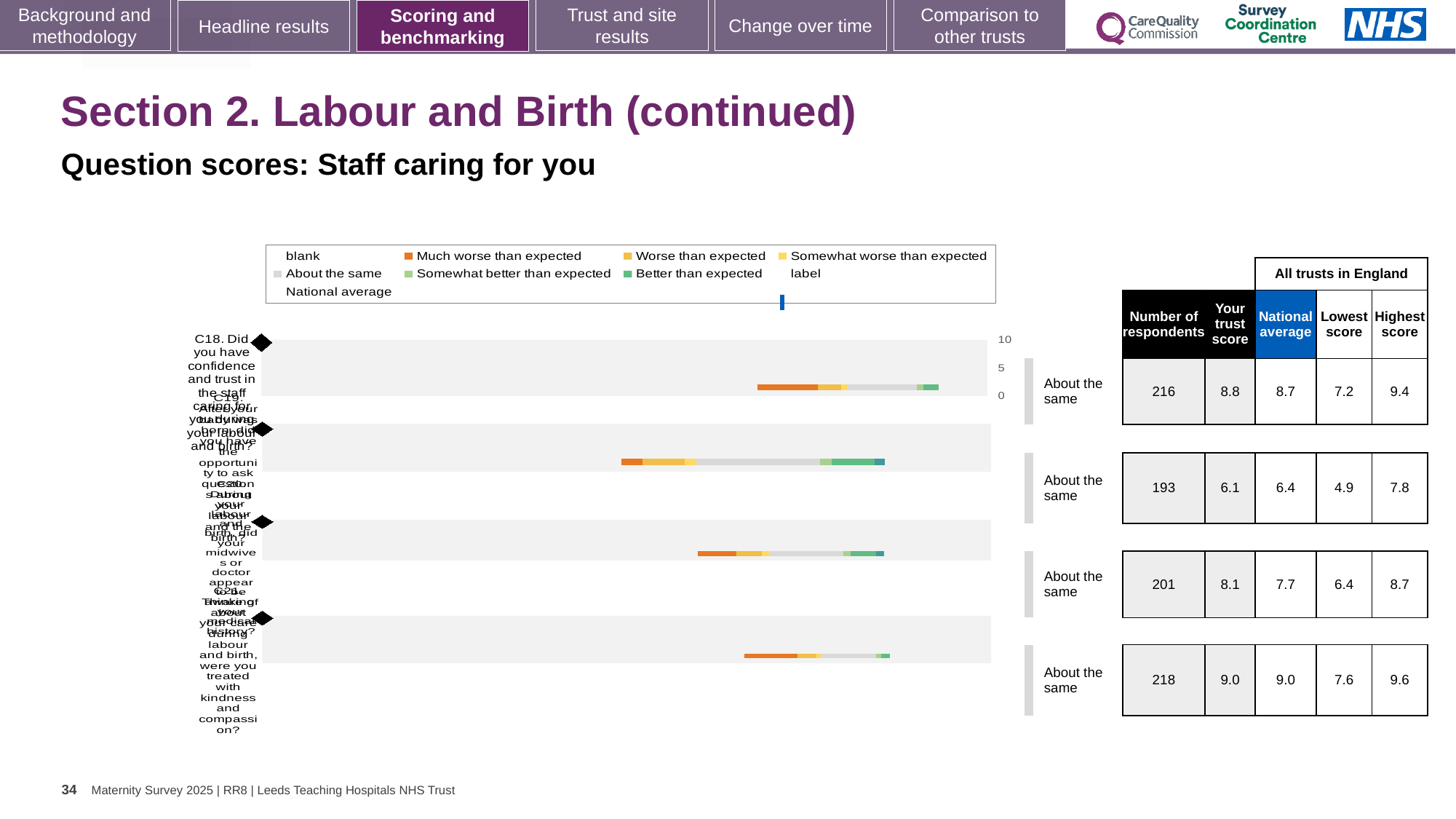
For C18, which is larger: the trust score or the national average? Your trust score What colour represents 'Much worse than expected' in the legend? orange For C18, what is the difference between the highest score (9.4) and the lowest score (7.2)? 2.2 How many question rows (bars) does the chart show? 4 How many respondents are listed for C18 (the first row)? 216 What is the 'Your trust score' for C18 (confidence and trust in the staff caring for you)? 8.8 What is the national average for C18 (confidence and trust in the staff caring for you)? 8.7 What is the highest score across all trusts in England for the last row (C21, treated with kindness and compassion)? 9.6 What kind of chart is shown on the slide? bar chart What is the highest 'Your trust score' shown in the table? 9.0 What is the smallest 'Lowest score' value shown in the table? 4.9 How many respondents are listed for the last row (C21, treated with kindness and compassion)? 218